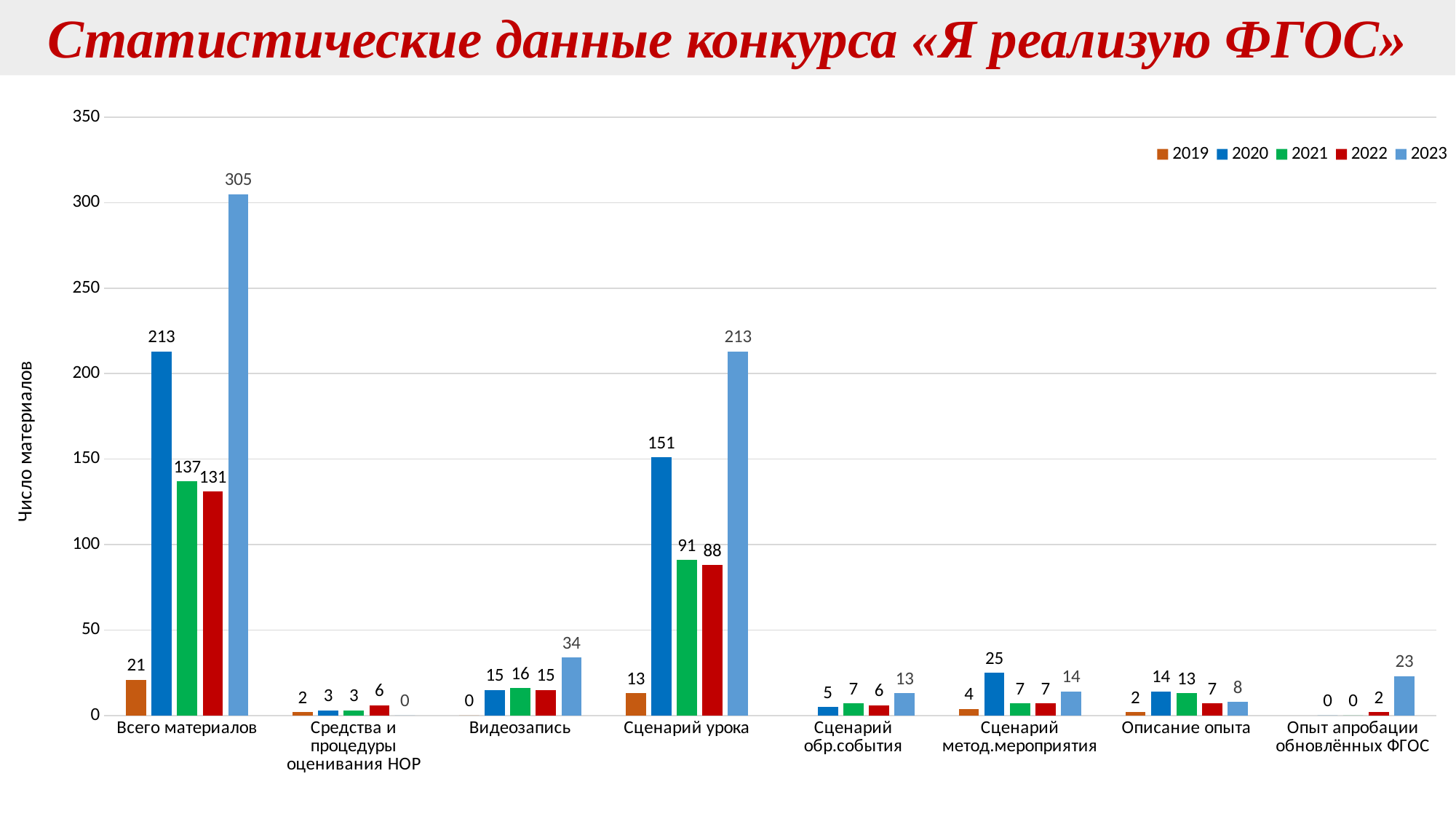
What is the value for 2023 in the category 'Видеозапись'? 34 Which year has the highest value in the category 'Сценарий метод.мероприятия'? 2020 What is the value for 2020 in the category 'Сценарий урока'? 151 What type of chart is shown on the slide? bar chart What is the label of the vertical axis? Число материалов How many series does the legend list? 5 What is the value for 2023 in the category 'Всего материалов'? 305 How many categories are shown on the x axis? 8 What is the difference between the 2023 and 2020 values in the category 'Всего материалов'? 92 Which year has the lowest value in the category 'Всего материалов'? 2019 What is the value for 2022 in the category 'Опыт апробации обновлённых ФГОС'? 2 Which is larger in the category 'Описание опыта': the value for 2020 or the value for 2023? 2020